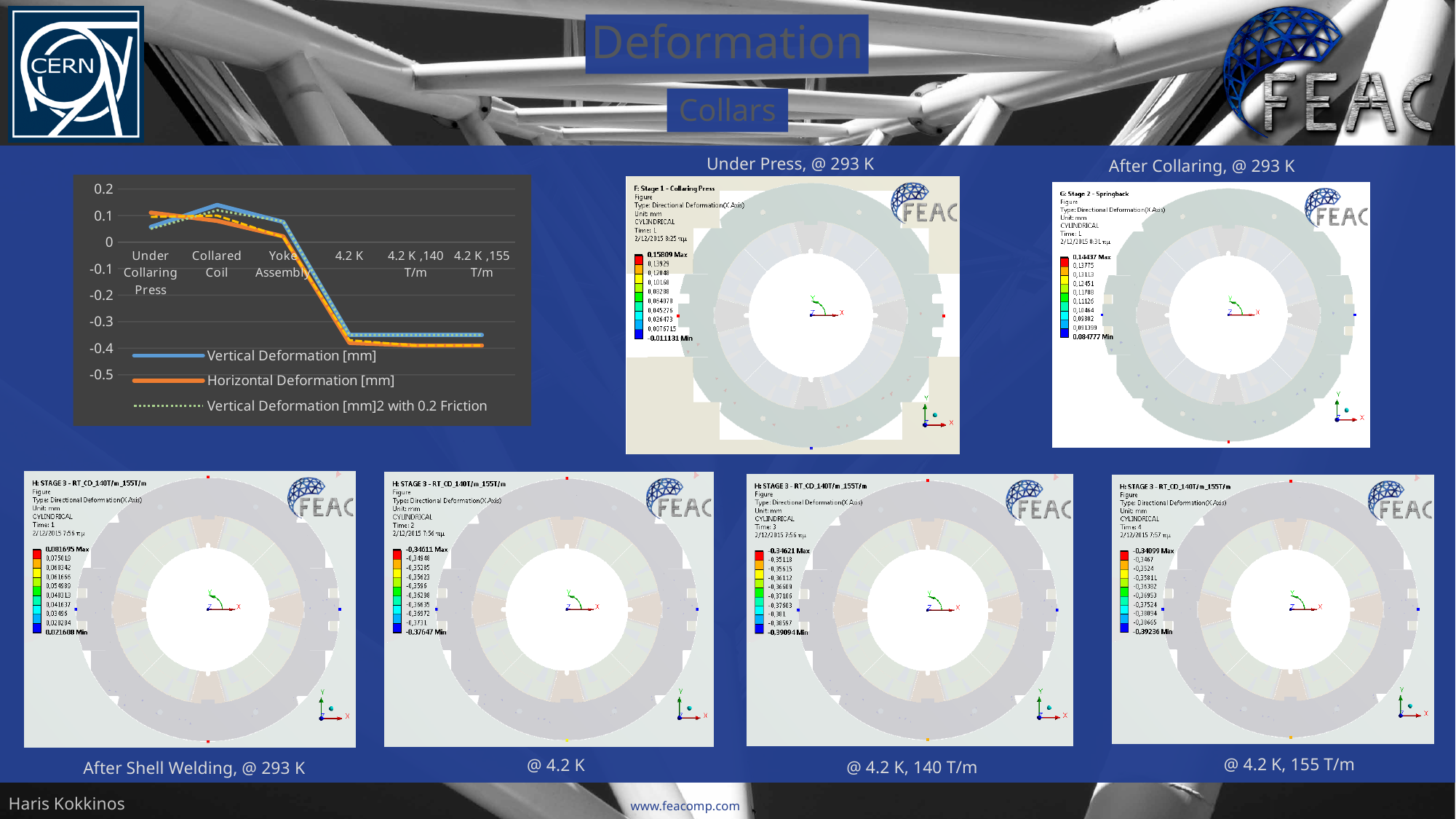
In the line chart, is the value of Vertical Deformation [mm] at 4.2 K greater or less than -0.3? less In the line chart, is the value of Horizontal Deformation [mm] at 4.2 K ,155 T/m greater or less than -0.3? less In the line chart, is the value of Vertical Deformation [mm] at Collared Coil greater or less than 0.1? greater In the line chart, do the Horizontal Deformation [mm] values rise or fall between Yoke Assembly and 4.2 K? fall Which series in the line chart is drawn with a dotted line? Vertical Deformation [mm]2 with 0.2 Friction What colour is the Horizontal Deformation [mm] line in the line chart? Orange How many series does the legend of the line chart list? 3 In the line chart, at Collared Coil, which is larger: Vertical Deformation [mm] or Horizontal Deformation [mm]? Vertical Deformation [mm] What kind of chart is shown on the left of the slide? Line chart In the line chart, at which category is Vertical Deformation [mm] highest? Collared Coil How many categories are shown along the x axis of the line chart? 6